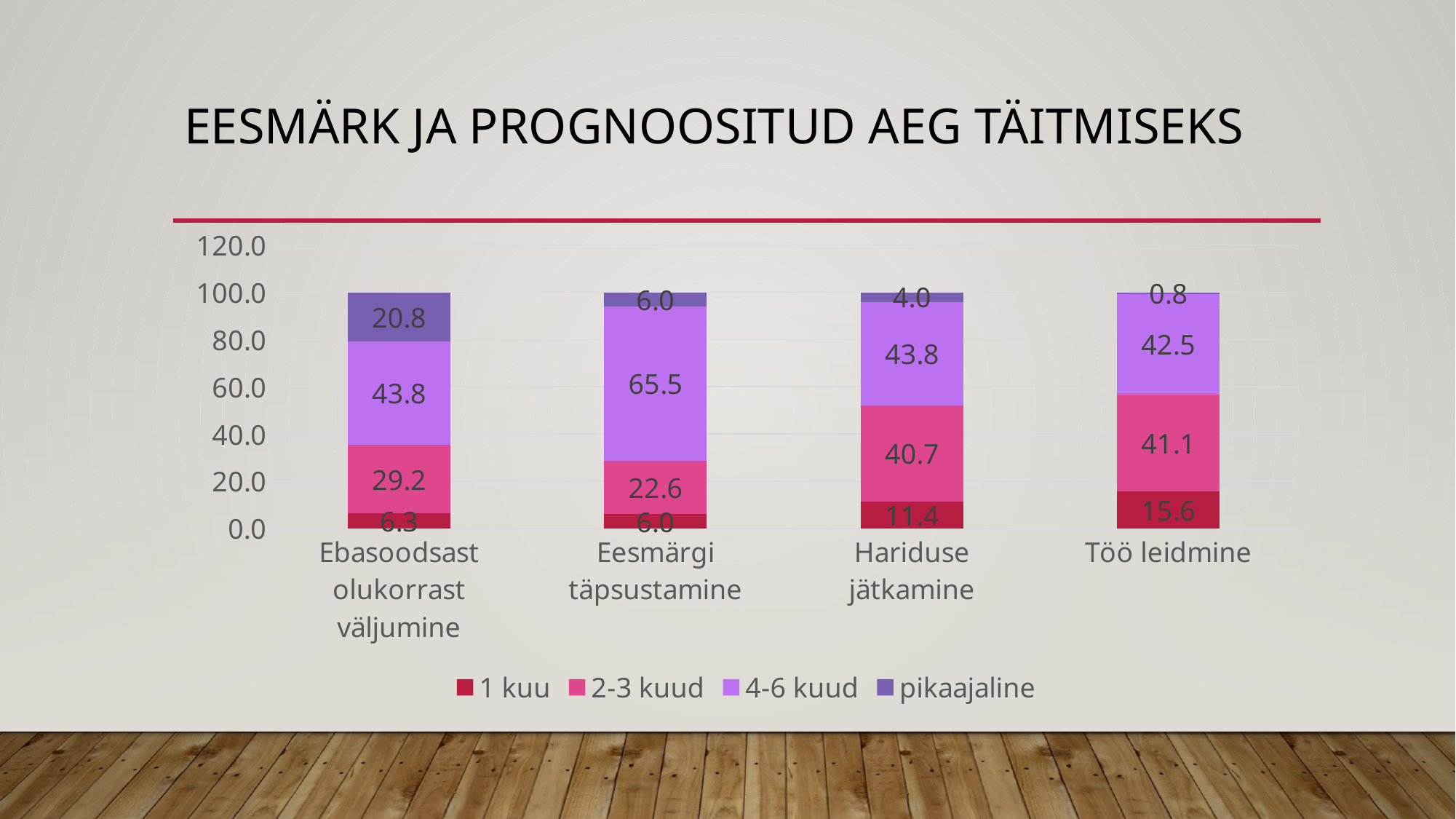
What is the value of the '4-6 kuud' series for 'Eesmärgi täpsustamine'? 65.5 How many series does the legend list? 4 What is the title of the chart on the slide? EESMÄRK JA PROGNOOSITUD AEG TÄITMISEKS What is the difference between the '2-3 kuud' values for 'Hariduse jätkamine' and 'Eesmärgi täpsustamine'? 18.1 What is the value of the 'pikaajaline' series for 'Ebasoodsast olukorrast väljumine'? 20.8 Which category has the highest value for the '2-3 kuud' series? Töö leidmine What is the value of the '1 kuu' series for 'Töö leidmine'? 15.6 What is the total of the stacked bar for 'Töö leidmine'? 100.0 Which category has the lowest value for the 'pikaajaline' series? Töö leidmine What kind of chart is shown on the slide? stacked bar chart Which is larger: the '1 kuu' value for 'Hariduse jätkamine' or for 'Ebasoodsast olukorrast väljumine'? Hariduse jätkamine How many categories are shown on the x axis? 4